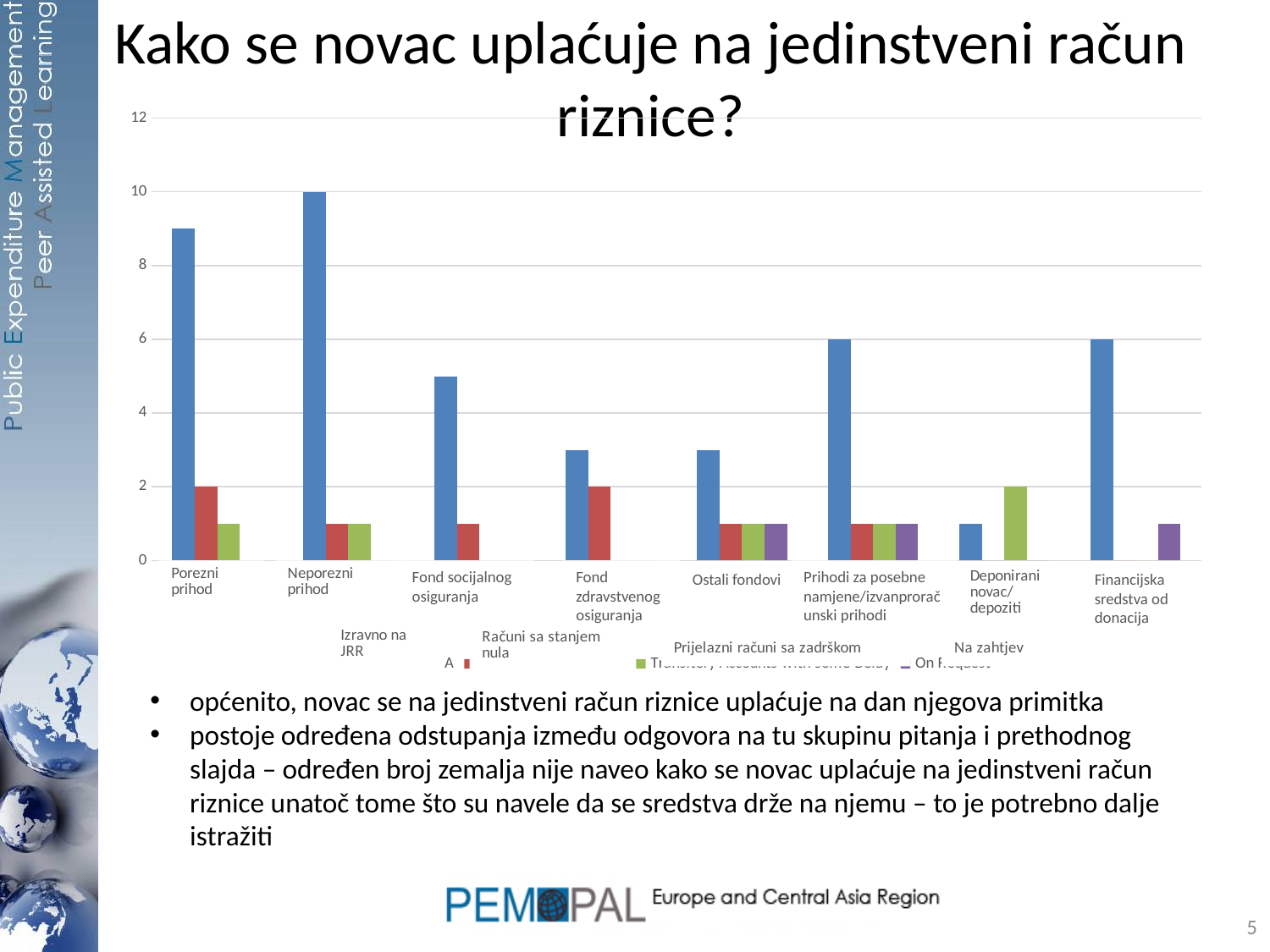
What is the value of the 'Izravno na JRR' series for 'Neporezni prihod'? 10 Is the 'Izravno na JRR' value for 'Fond socijalnog osiguranja' greater or less than 6? less Which category has the lowest value for the 'Izravno na JRR' series? Deponirani novac/depoziti Which is larger for the 'Izravno na JRR' series: 'Prihodi za posebne namjene/izvanproračunski prihodi' or 'Ostali fondovi'? Prihodi za posebne namjene/izvanproračunski prihodi What kind of chart is shown on the slide? bar chart What is the value of the 'Izravno na JRR' series for 'Financijska sredstva od donacija'? 6 How many series does the chart's legend list? 4 What is the value of the 'Računi sa stanjem nula' series for 'Porezni prihod'? 2 Is the 'Izravno na JRR' value for 'Porezni prihod' greater or less than 8? greater Which category has the highest value for the 'Izravno na JRR' series? Neporezni prihod What is the value of the 'Prijelazni računi sa zadrškom' series for 'Deponirani novac/depoziti'? 2 How many categories are shown along the x axis of the chart? 8